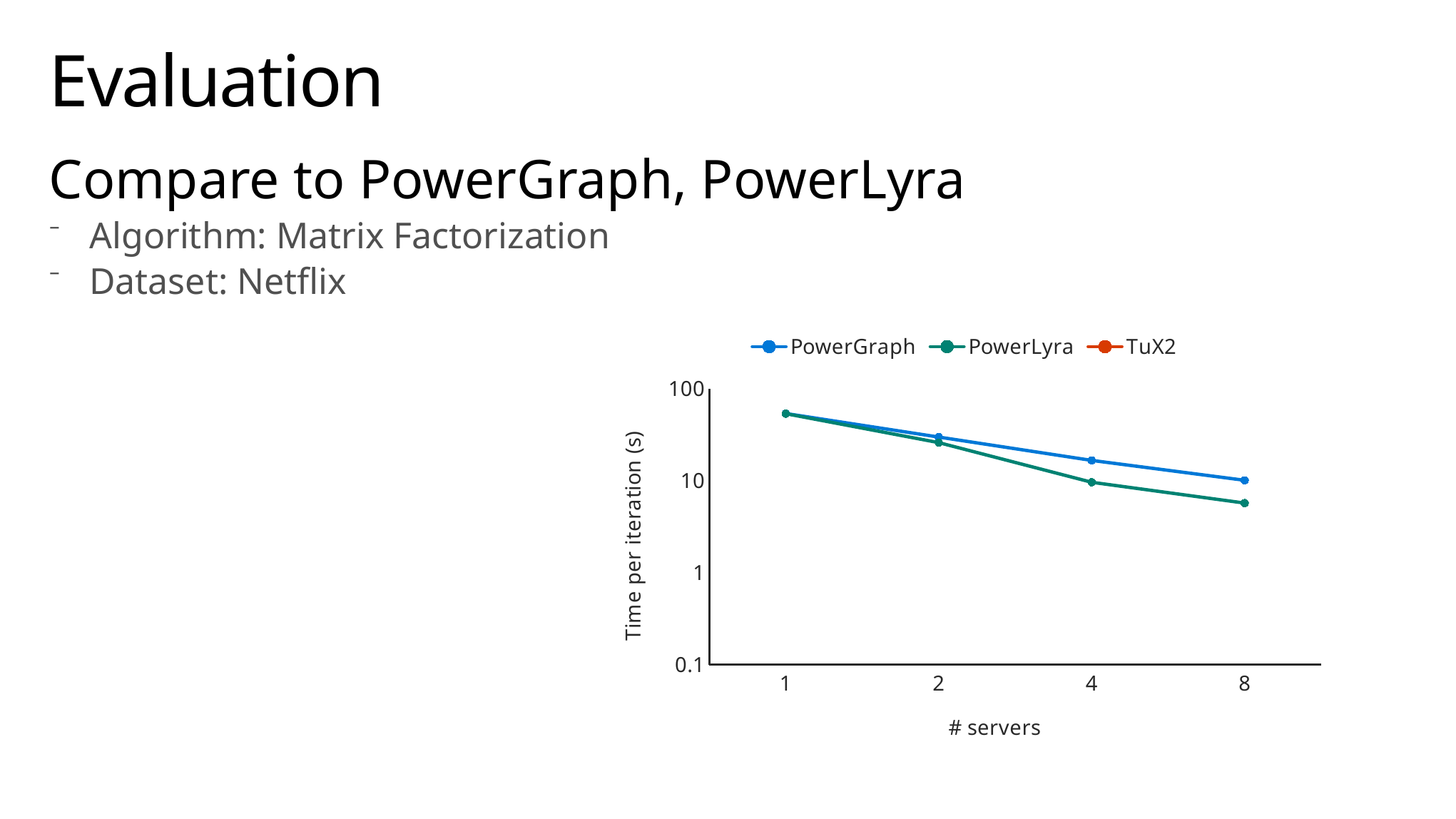
At 8 servers, which has the higher time per iteration, PowerGraph or PowerLyra? PowerGraph What kind of chart is shown on the slide? line chart Is the time per iteration for PowerLyra at 2 servers greater or less than 10? greater Is the time per iteration for PowerGraph at 4 servers greater or less than 10? greater At 4 servers, which has the lower time per iteration, PowerGraph or PowerLyra? PowerLyra Does the time per iteration for PowerLyra rise or fall as the number of servers increases? fall Is the time per iteration for PowerLyra at 8 servers greater or less than 10? less How many points along the x axis (# servers) are plotted for each series? 4 How many series does the legend list? 3 What is the label of the y axis? Time per iteration (s) Does the time per iteration for PowerGraph rise or fall as the number of servers increases? fall